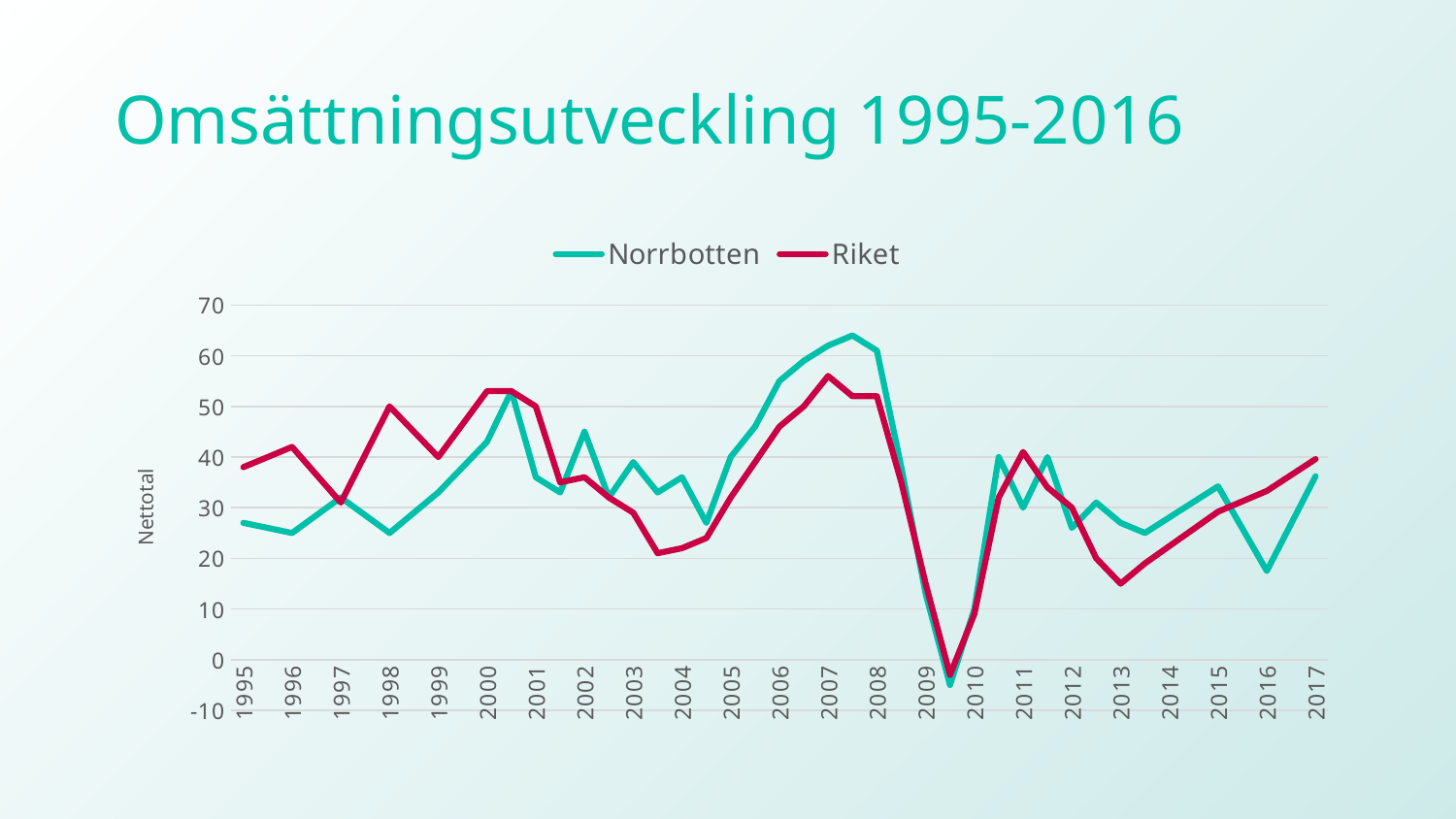
What kind of chart is shown on the slide? line chart Is the value for Riket in 2013 greater or less than 20? less How many series does the legend list? 2 Which two series are shown in the legend? Norrbotten and Riket In 2016, which series has the higher value, Norrbotten or Riket? Riket In 2013, which series has the higher value, Norrbotten or Riket? Norrbotten Does the Norrbotten series rise or fall between 2007 and 2009? fall What is the title of the chart? Omsättningsutveckling 1995-2016 How many years are labelled on the x axis? 23 In which year does the Norrbotten series reach its highest value? 2007 Is the value for Norrbotten in 2007 greater or less than 60? greater